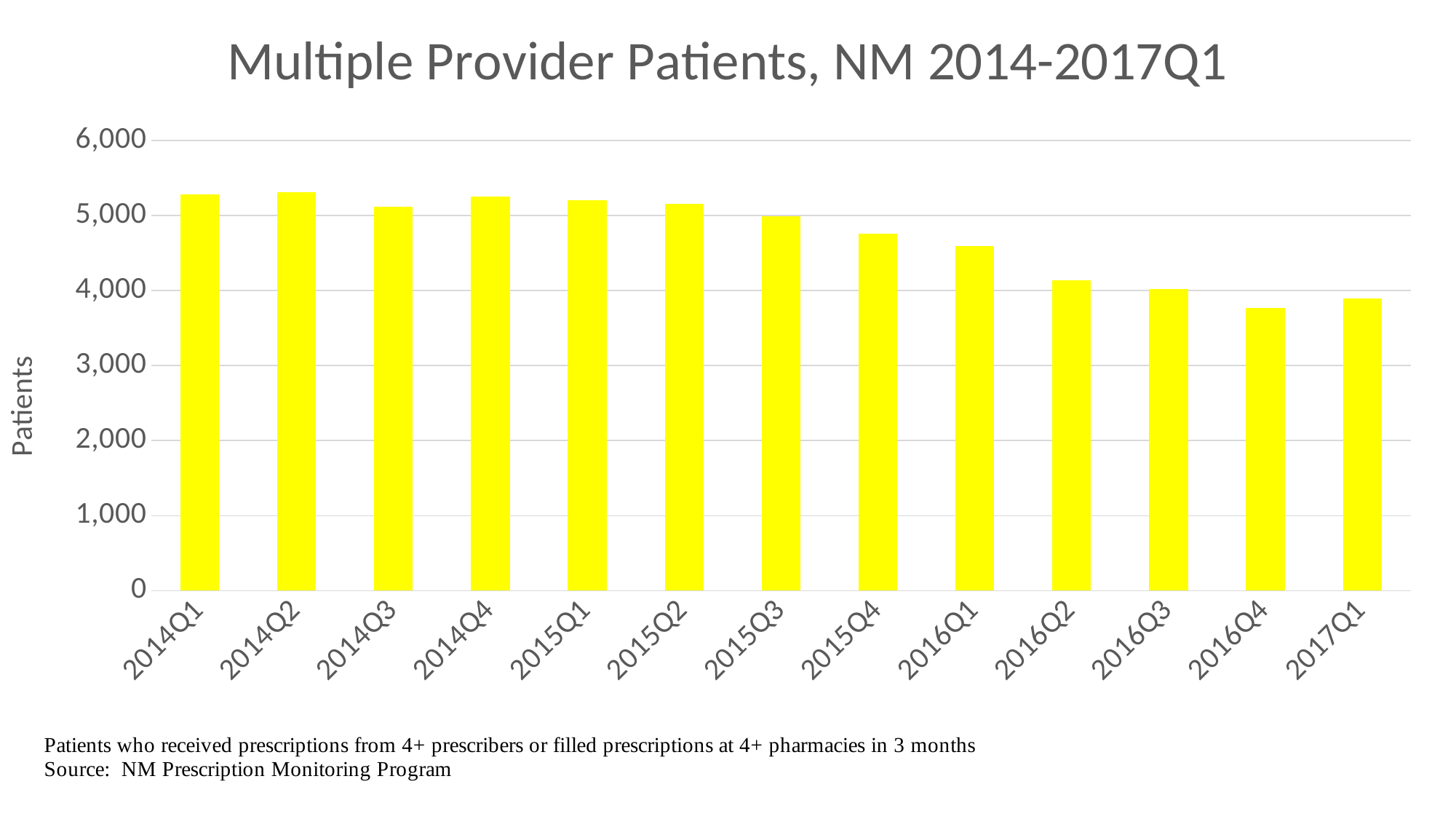
Is the value for 2016Q4 greater or less than 4,000? less Is the value for 2015Q4 greater or less than 5,000? less Is the value for 2014Q1 greater or less than 5,000? greater What is the label on the vertical axis? Patients What kind of chart is shown on the slide? Bar chart Which quarter has the lowest number of patients? 2016Q4 Which has more patients, 2015Q1 or 2016Q2? 2015Q1 What is the title of the chart? Multiple Provider Patients, NM 2014-2017Q1 How many quarters are plotted on the chart? 13 Do the values generally rise or fall from 2014Q1 to 2017Q1? fall Which has more patients, 2014Q1 or 2016Q4? 2014Q1